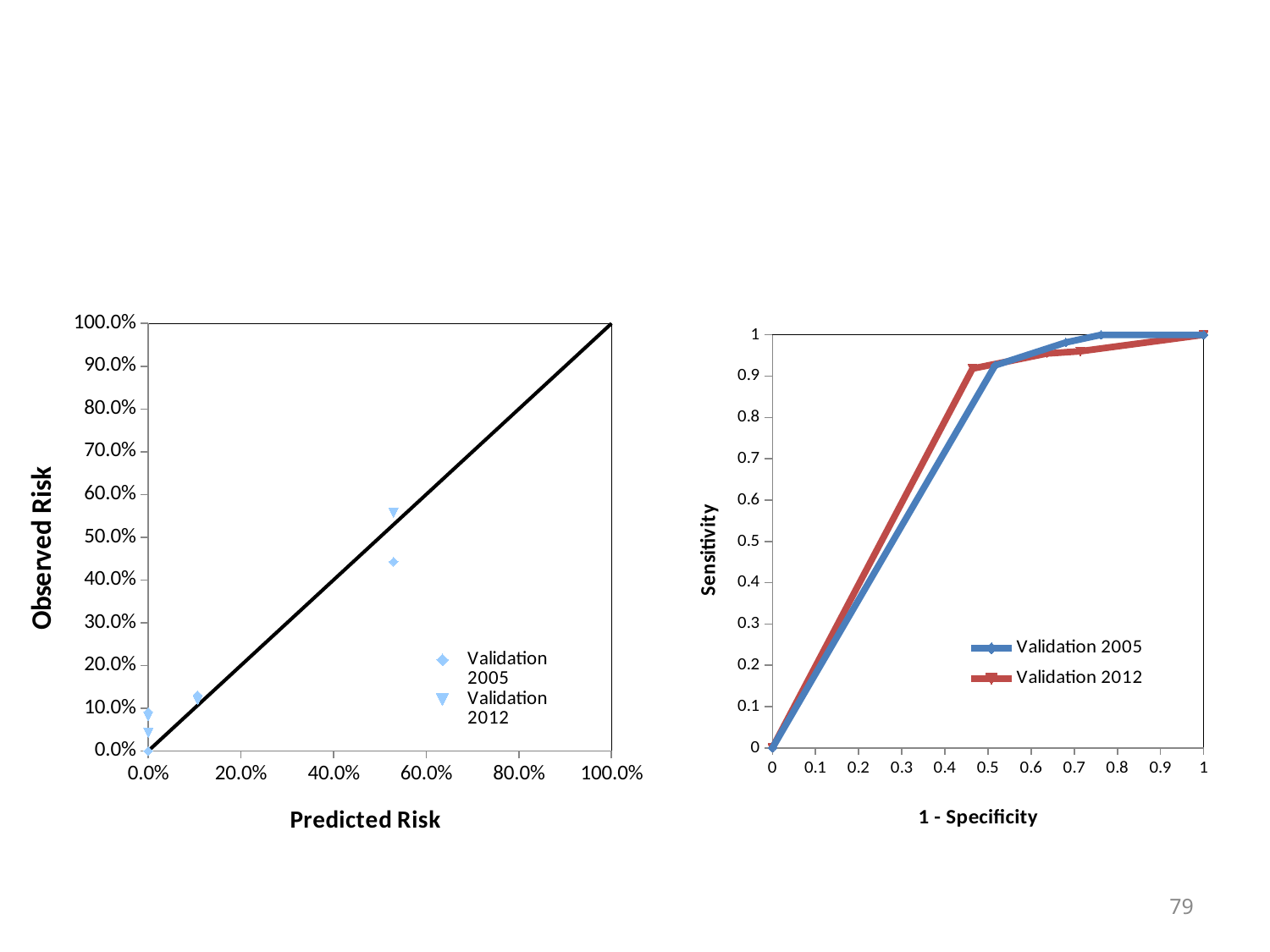
What kind of chart is the chart on the right of the slide? line chart What is the x-axis title of the left chart? Predicted Risk What kind of chart is the chart on the left of the slide? scatter chart In the left chart, is the observed risk for the Validation 2005 point plotted near 53% predicted risk greater or less than 50.0%? less In the left chart, which series has the higher observed risk at the points plotted near 53% predicted risk, Validation 2005 or Validation 2012? Validation 2012 In the right chart, does sensitivity rise or fall as 1 - Specificity increases from 0 to 1? rise In the right chart, which series has the higher sensitivity at 1 - Specificity of 0.4, Validation 2005 or Validation 2012? Validation 2012 What is the y-axis title of the right chart? Sensitivity In the left chart, is the observed risk for the Validation 2012 point plotted near 53% predicted risk greater or less than 50.0%? greater How many series does the legend of the left chart list? 2 How many series does the legend of the right chart list? 2 In the right chart, is the sensitivity of Validation 2012 at 1 - Specificity of about 0.46 greater or less than 0.8? greater